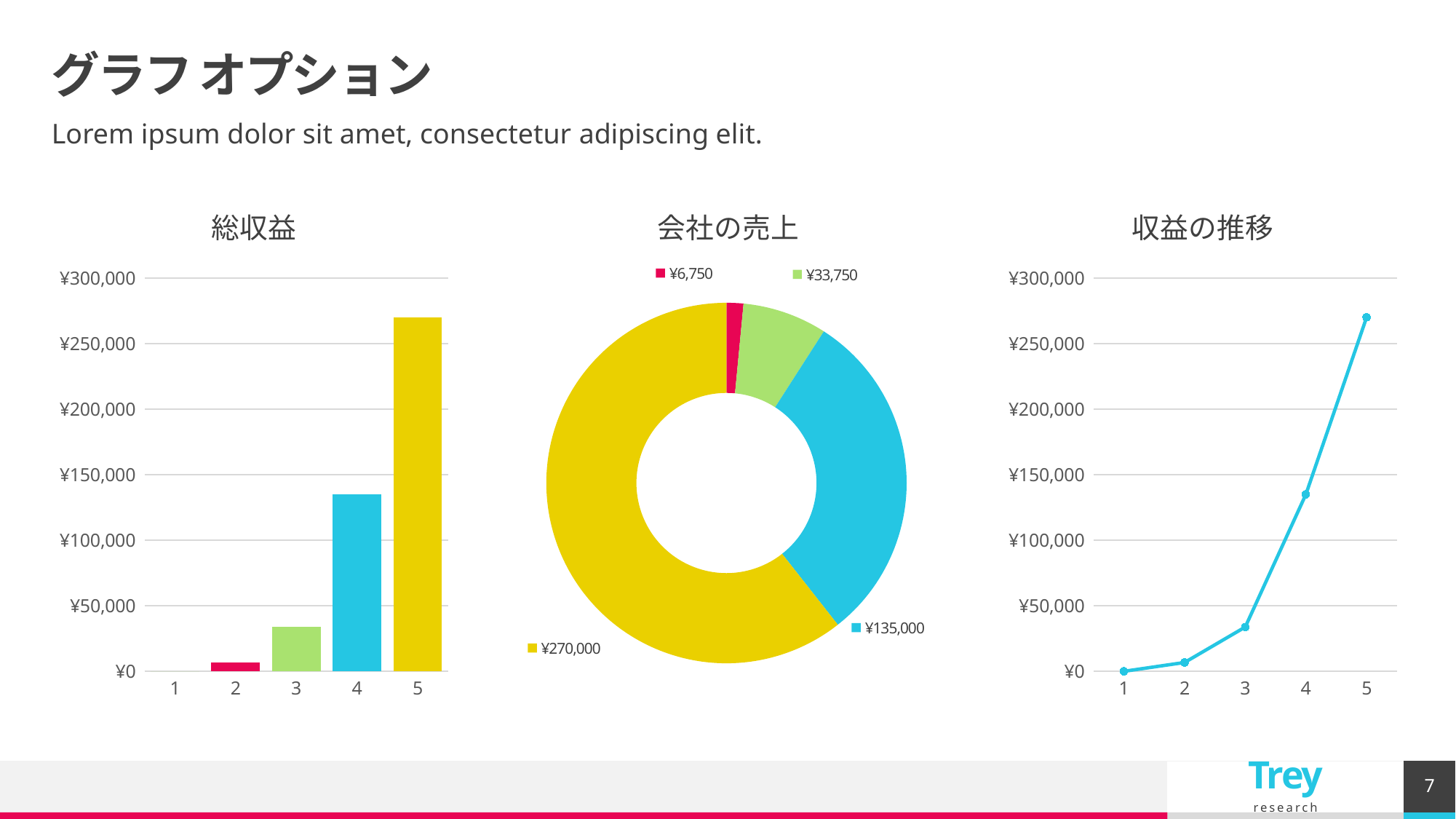
What kind of chart is the chart titled 総収益? bar chart In the chart titled 総収益, how many categories are shown on the x axis? 5 In the chart titled 会社の売上, what is the difference between the largest slice and the smallest slice? ¥263,250 In the chart titled 会社の売上, what is the value of the smallest slice? ¥6,750 In the chart titled 会社の売上, how many slices are there? 4 In the chart titled 総収益, is the value for category 3 greater or less than ¥50,000? less In the chart titled 収益の推移, do the values rise or fall from category 1 to category 5? rise In the chart titled 収益の推移, is the value at point 5 greater or less than ¥250,000? greater In the chart titled 会社の売上, what is the value of the largest slice? ¥270,000 In the chart titled 総収益, is the value for category 4 greater or less than ¥100,000? greater In the chart titled 総収益, which is larger, the bar for category 2 or the bar for category 3? 3 In the chart titled 総収益, which category has the highest bar? 5